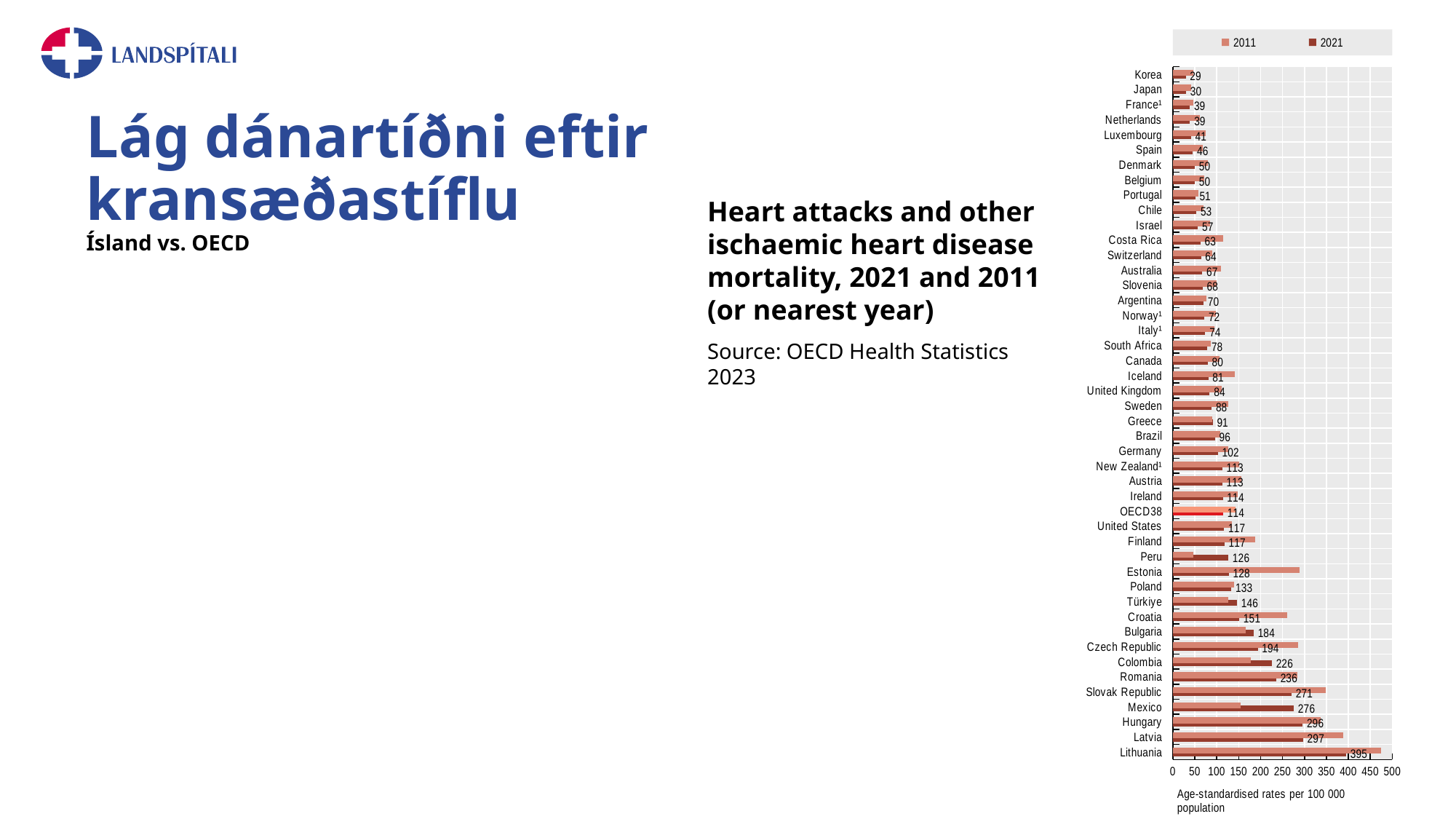
What is the 2021 value for Mexico? 276 Is the 2011 value for Lithuania greater or less than 450? greater What is the 2021 value for OECD38? 114 Which country has the highest 2021 value? Lithuania What kind of chart is shown on the slide? Bar chart Is the 2011 value for Estonia greater or less than 250? greater What is the difference between the 2021 values for OECD38 and Iceland? 33 Which country has the lowest 2021 value? Korea Which has the larger 2021 value, Mexico or Romania? Mexico What is the source cited for the chart? OECD Health Statistics 2023 How many series does the legend list? 2 What is the 2021 value for Iceland? 81